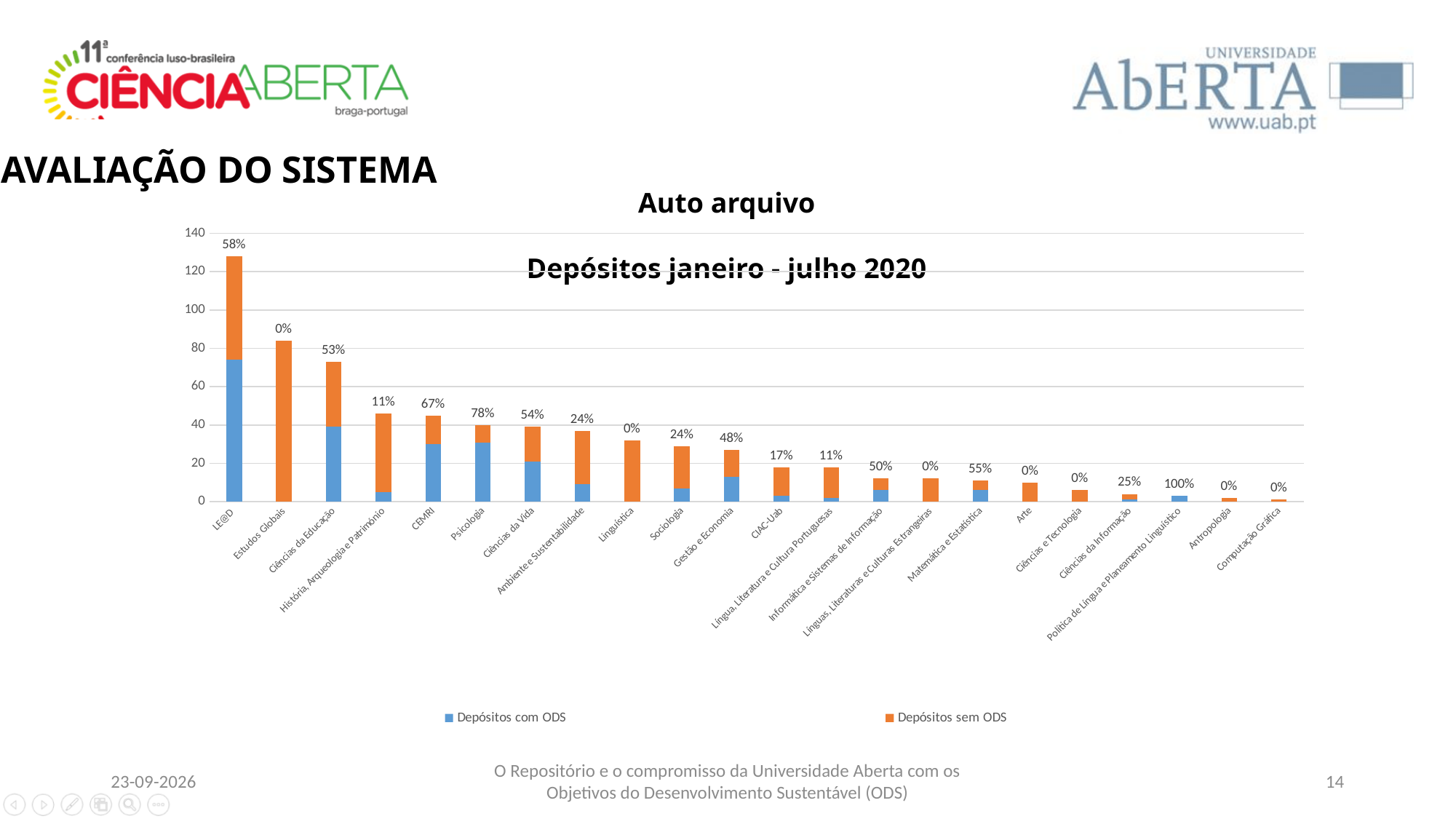
Which total bar is taller, Estudos Globais or CEMRI? Estudos Globais What percentage label is shown above the bar for Ciências da Educação? 53% How many categories are shown on the x axis of the chart? 22 What percentage label is shown above the bar for Psicologia? 78% Which category has the tallest total bar in the chart? LE@D What kind of chart is shown on the slide? stacked bar chart Is the total bar for LE@D greater or less than 120? greater What percentage label is shown above the bar for LE@D? 58% Is the total bar for Estudos Globais greater or less than 100? less How many series does the chart legend list? 2 What percentage label is shown above the bar for Política de Língua e Planeamento Linguístico? 100% Which series is shown in orange in the chart legend? Depósitos sem ODS